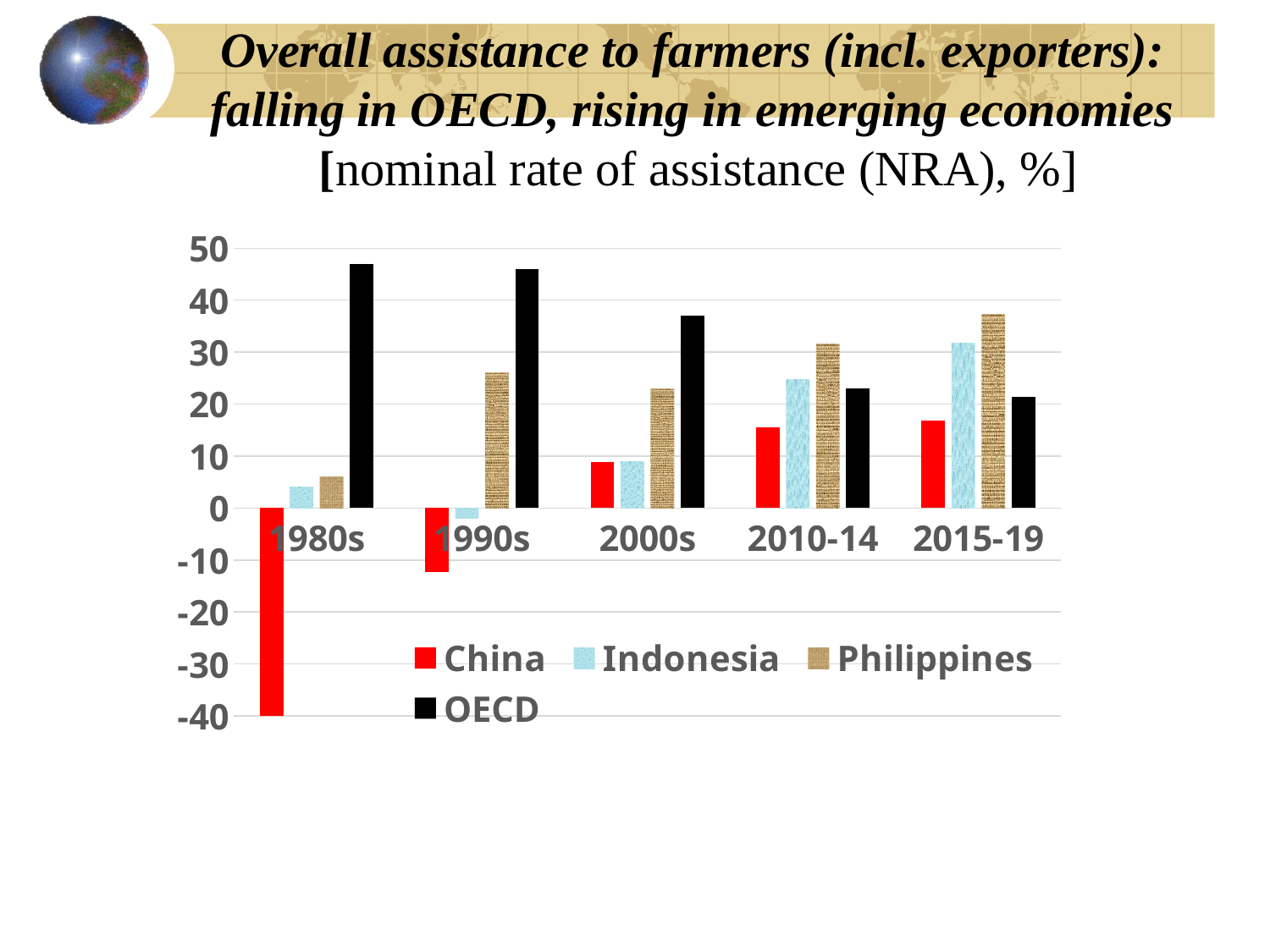
Which series has the lowest value in the 1980s? China Which series has the highest value in 2015-19? Philippines Which series has the highest value in the 1980s? OECD Does the OECD value rise or fall from the 1980s to 2015-19? fall What kind of chart is shown on the slide? bar chart Is the value for China in 2015-19 greater or less than 10? greater Is the value for Indonesia in 2010-14 greater or less than 20? greater Does the China value rise or fall from the 1980s to 2015-19? rise How many time periods are shown on the x axis? 5 In 2010-14, which is larger: the value for Philippines or the value for OECD? Philippines Is the value for OECD in the 1980s greater or less than 40? greater How many series does the legend list? 4